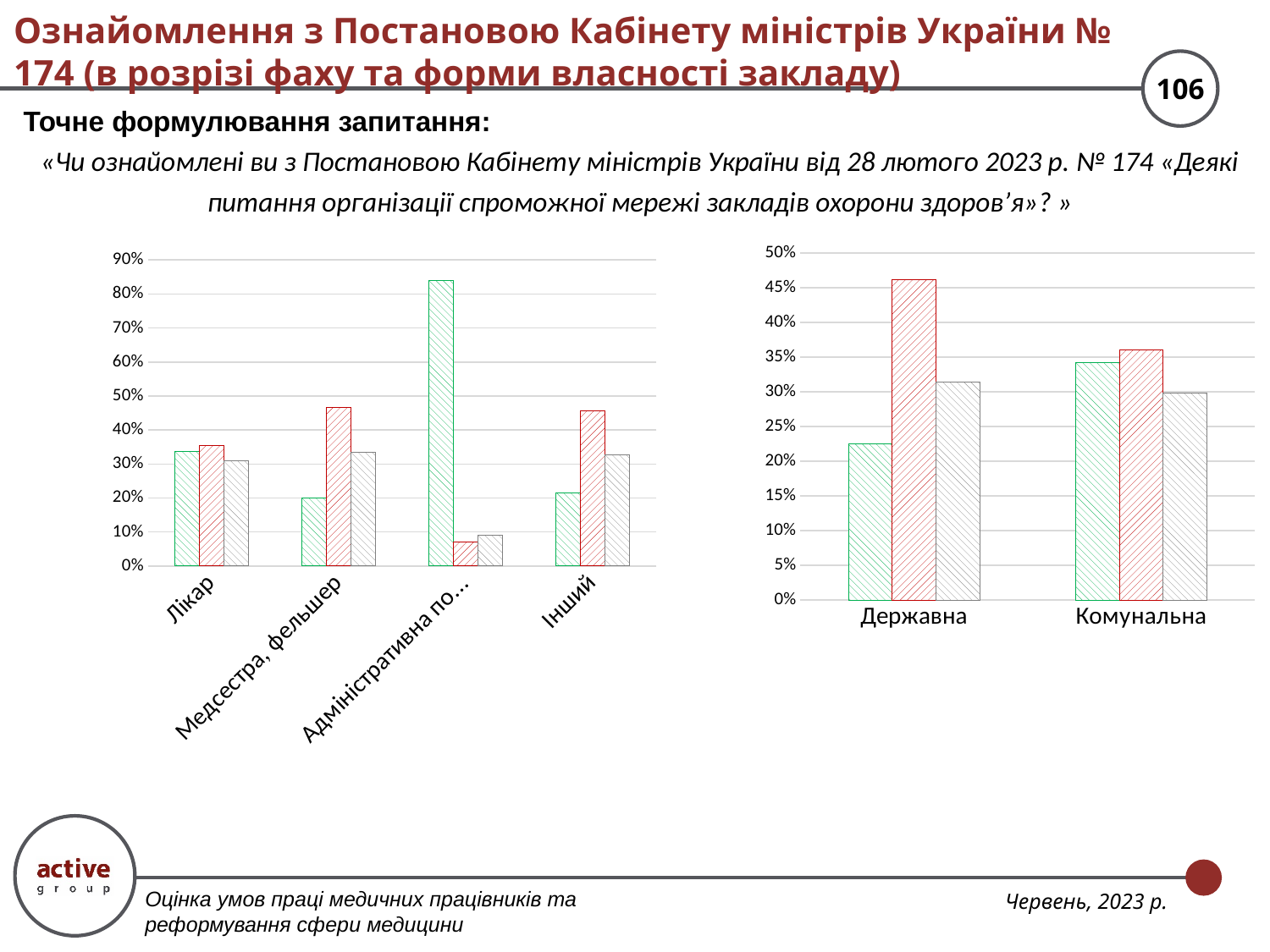
How many categories are shown on the x axis of the right chart? 2 In the right chart, is the red bar for Державна greater or less than 40%? greater In the left chart, which category has the tallest green bar? Адміністративна по... What kind of chart is the left chart on the slide? bar chart In the left chart, is the red bar for Медсестра, фельшер greater or less than 40%? greater What is the highest value shown on the y axis of the right chart? 50% In the right chart, which is larger: the green bar for Державна or the green bar for Комунальна? Комунальна In the left chart, which category has the shortest red bar? Адміністративна по... In the right chart, is the green bar for Державна greater or less than 25%? less How many categories are shown on the x axis of the left chart? 4